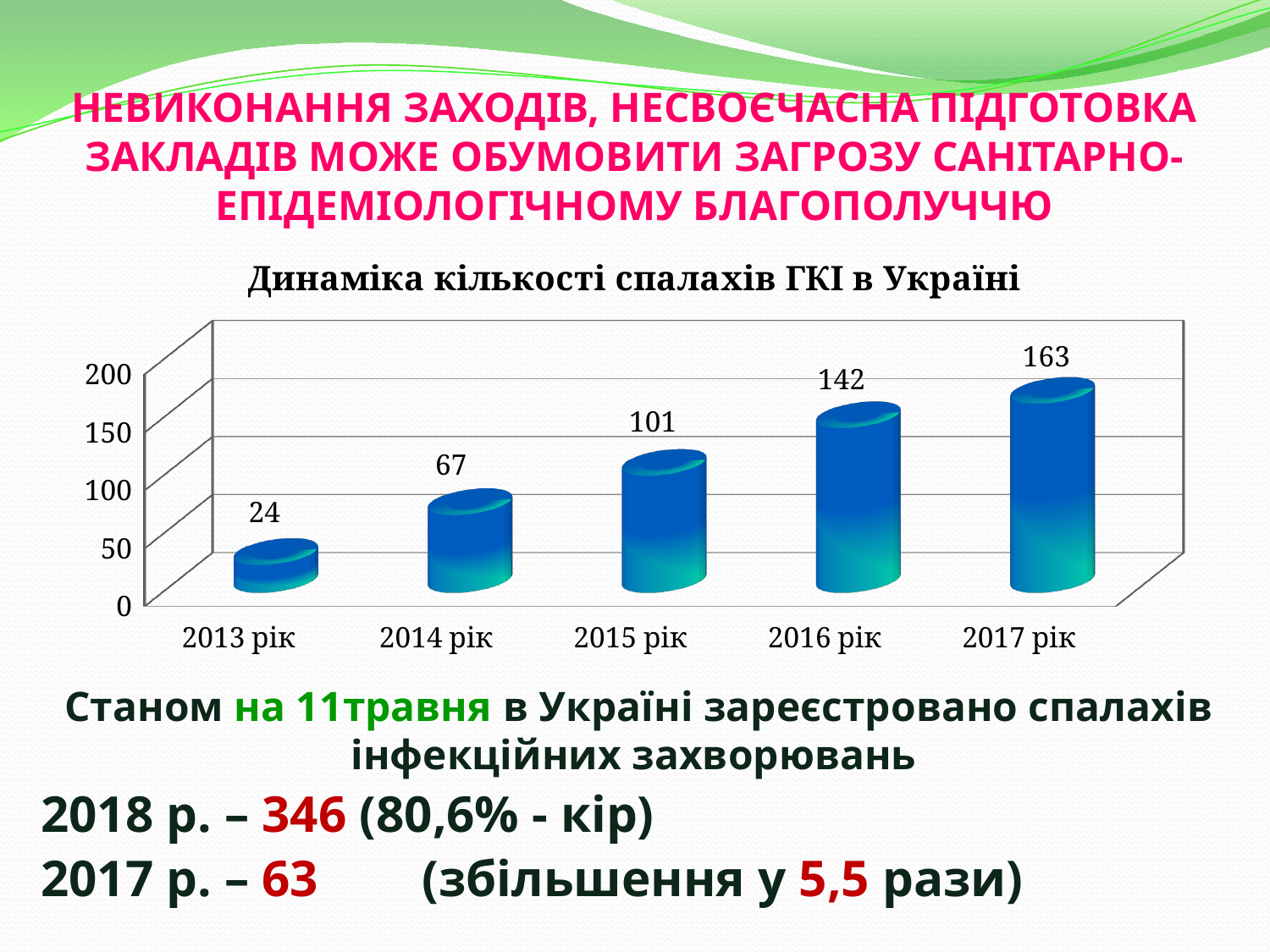
Do the values rise or fall from 2013 рік to 2017 рік? rise What is the value for 2013 рік? 24 What is the difference between the values for 2014 рік and 2013 рік? 43 Which is larger, the value for 2014 рік or the value for 2015 рік? 2015 рік What is the value for 2017 рік? 163 Is the value for 2016 рік greater or less than 100? greater What kind of chart is shown? bar chart What is the value for 2015 рік? 101 What is the difference between the values for 2017 рік and 2016 рік? 21 Which year has the lowest value? 2013 рік How many years are shown on the x axis? 5 Which year has the highest value? 2017 рік